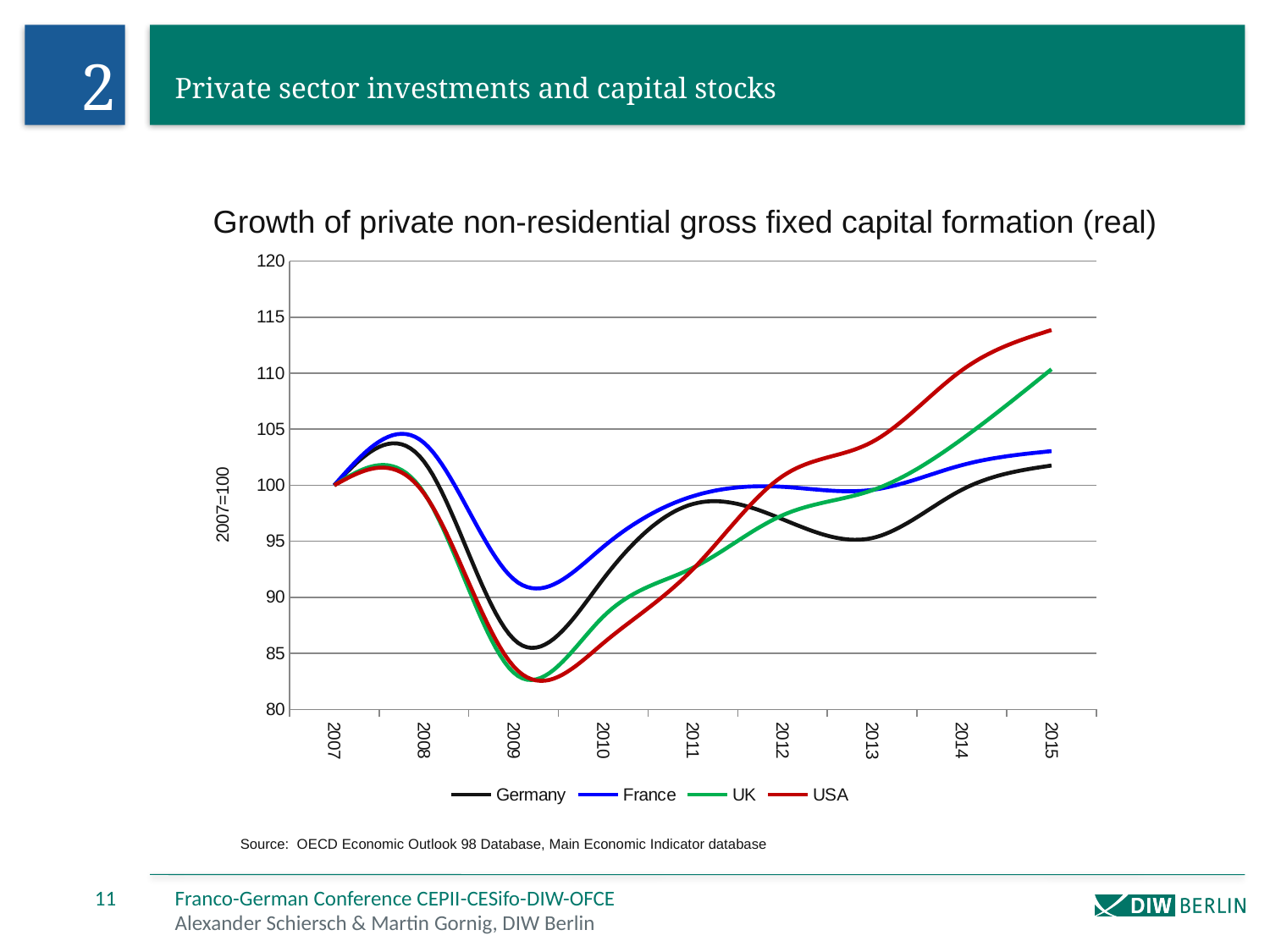
What is the value for Germany in 2007? 100 Which country has the highest value in 2009? France Does the USA line rise or fall between 2009 and 2015? rise How many years are labelled on the x axis? 9 What kind of chart is shown on the slide? line chart Which country has the highest value in 2015? USA Is the value for USA in 2009 greater or less than 85? less Is the value for USA in 2015 greater or less than 110? greater Which is larger in 2015, the value for USA or the value for Germany? USA Is the value for France in 2009 greater or less than 95? less Which country has the lowest value in 2015? Germany How many series does the legend list? 4